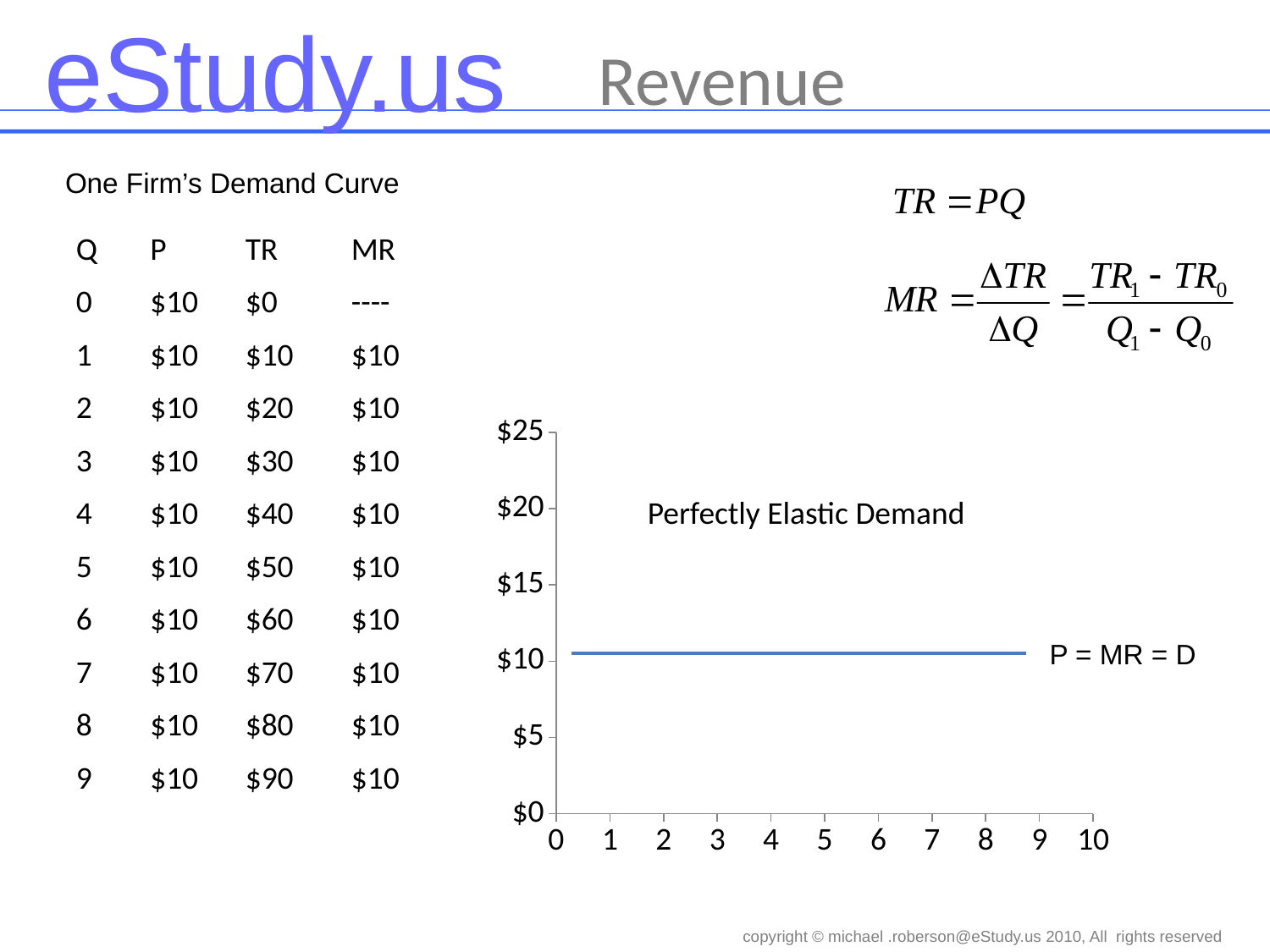
Is the value of the line at a quantity of 3 greater or less than $15? less What text label is placed next to the right end of the plotted line? P = MR = D Is the value of the line at a quantity of 2 greater or less than $20? less What is the value of the line at a quantity of 5? $10 What is the highest value shown on the y axis of the chart? $25 How many tick labels are shown on the y axis of the chart? 6 What value does the horizontal line sit at on the y axis? $10 Does the plotted line rise, fall, or stay flat as quantity increases along the x axis? stays flat What kind of chart is shown on the slide? line chart Is the value of the line at a quantity of 7 greater or less than $5? greater